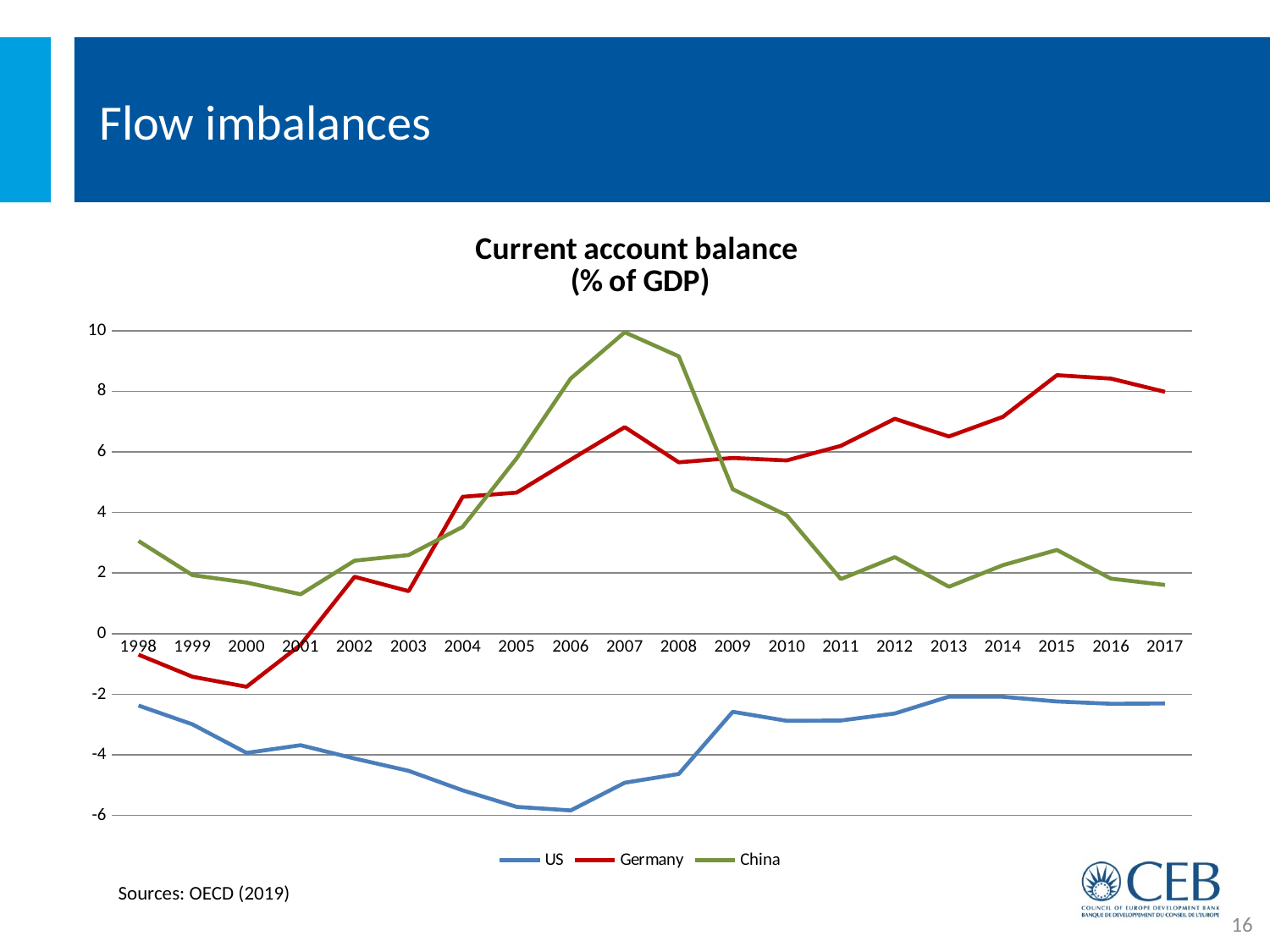
Which series has the lowest value in 2017? US How many series does the legend list? 3 In 2006, which is larger: the value for Germany or the value for China? China Which series has the highest value in 2007? China Is the value for Germany in 2000 greater or less than 0? less In 2017, which is larger: the value for Germany or the value for China? Germany Does the China line rise or fall between 2007 and 2011? Fall What kind of chart is shown on the slide? Line chart What is the title of the chart? Current account balance (% of GDP) Is the value for the US in 2006 greater or less than -4? less Is the value for China in 2007 greater or less than 8? greater How many years are shown along the x axis? 20